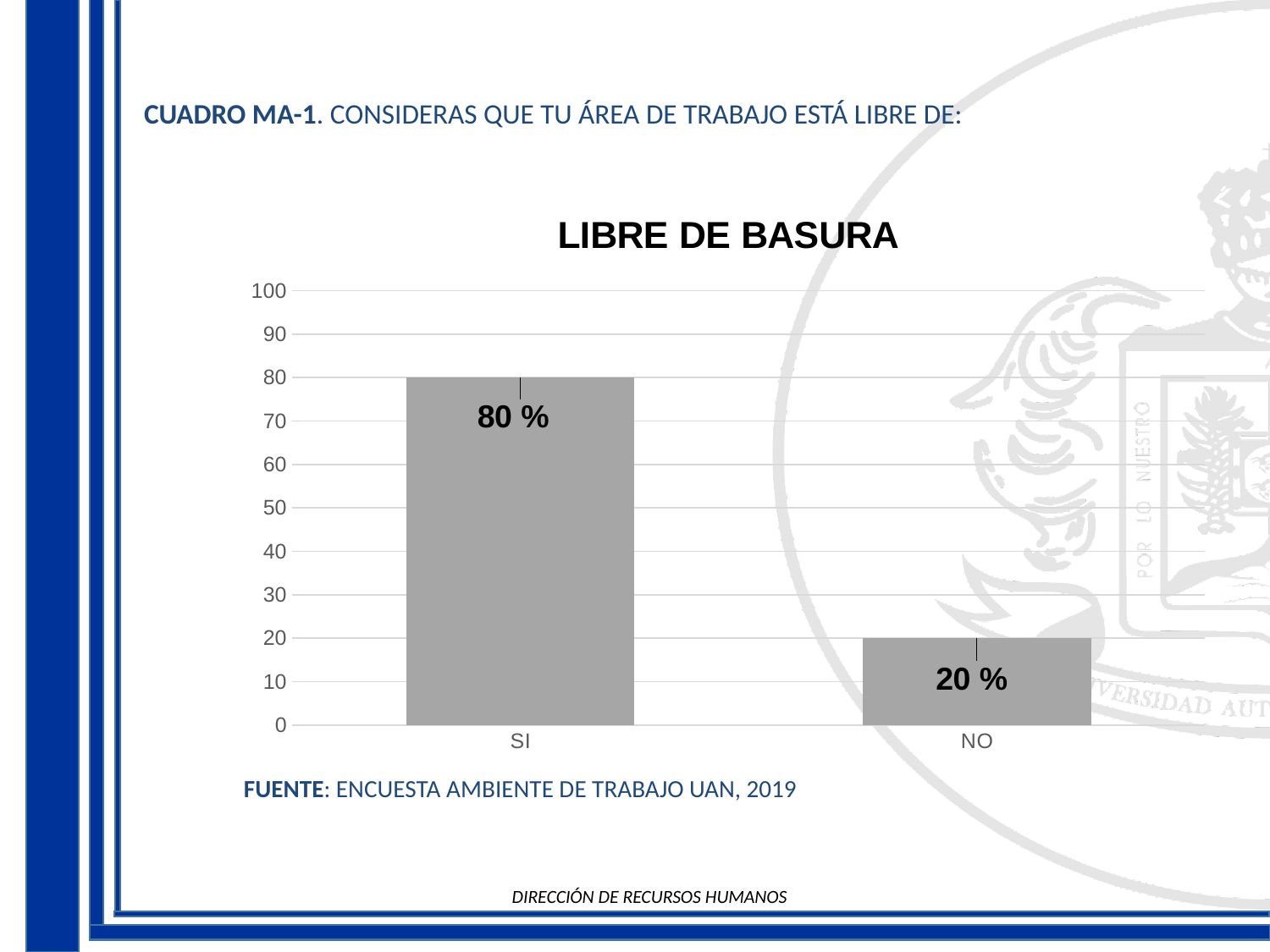
What is the value for SI? 80 % What is the maximum value shown on the y axis? 100 What is the value for NO? 20 % Is the value for NO greater or less than 50? less What is the difference between the values for SI and NO? 60 % What is the title of the chart? LIBRE DE BASURA What kind of chart is this? bar chart Which is larger, the value for SI or the value for NO? SI Which category has the highest value? SI How many categories are shown on the x axis? 2 Is the value for SI greater or less than 70? greater Which category has the lowest value? NO